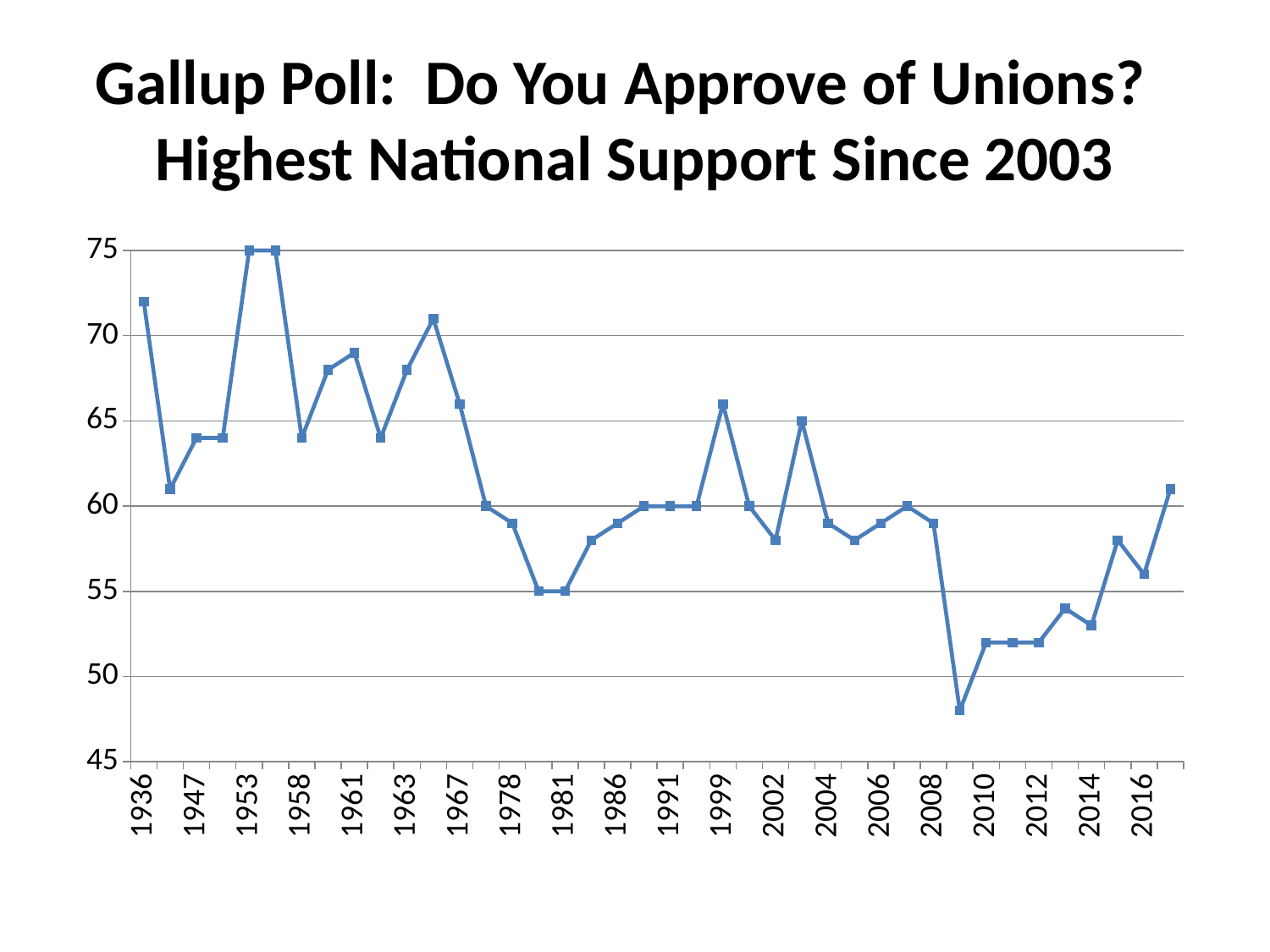
What kind of chart is shown on the slide? line chart What is the approval value for 1991? 60 Is the value for 1936 greater or less than 70? greater What is the approval value for 1981? 55 Overall, do the values rise or fall from 1936 to 2016? fall Is the value for 2016 greater or less than 60? less Is the lowest point on the chart greater or less than 50? less What is the title of the chart? Gallup Poll: Do You Approve of Unions? Highest National Support Since 2003 Which is larger, the value for 1953 or the value for 2010? 1953 What is the approval value for 1953? 75